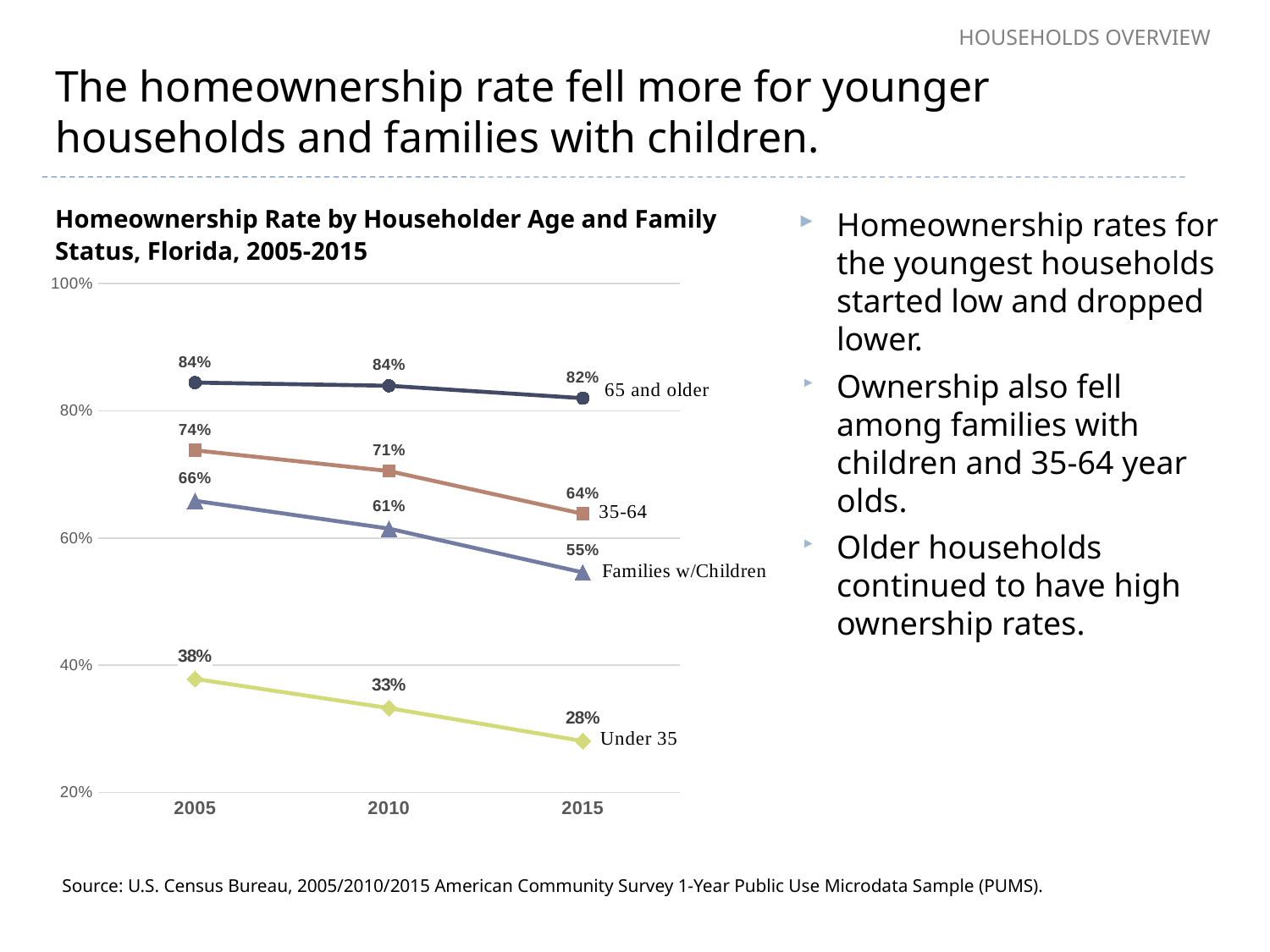
Which group had the lowest homeownership rate in 2005? Under 35 Which was higher in 2010: the 35-64 rate or the Families w/Children rate? 35-64 What type of chart is shown on the slide? Line chart What was the homeownership rate for Under 35 households in 2015? 28% What was the homeownership rate for the 65 and older group in 2005? 84% By how many percentage points did the Under 35 homeownership rate fall from 2005 to 2015? 10 percentage points How many series are plotted on the chart? 4 What is the difference between the 35-64 rate and the Families w/Children rate in 2015? 9 percentage points What was the homeownership rate for Families w/Children in 2010? 61% Which group had the highest homeownership rate in 2015? 65 and older What was the homeownership rate for the 35-64 group in 2015? 64% Does the homeownership rate for Families w/Children rise or fall from 2005 to 2015? Fall